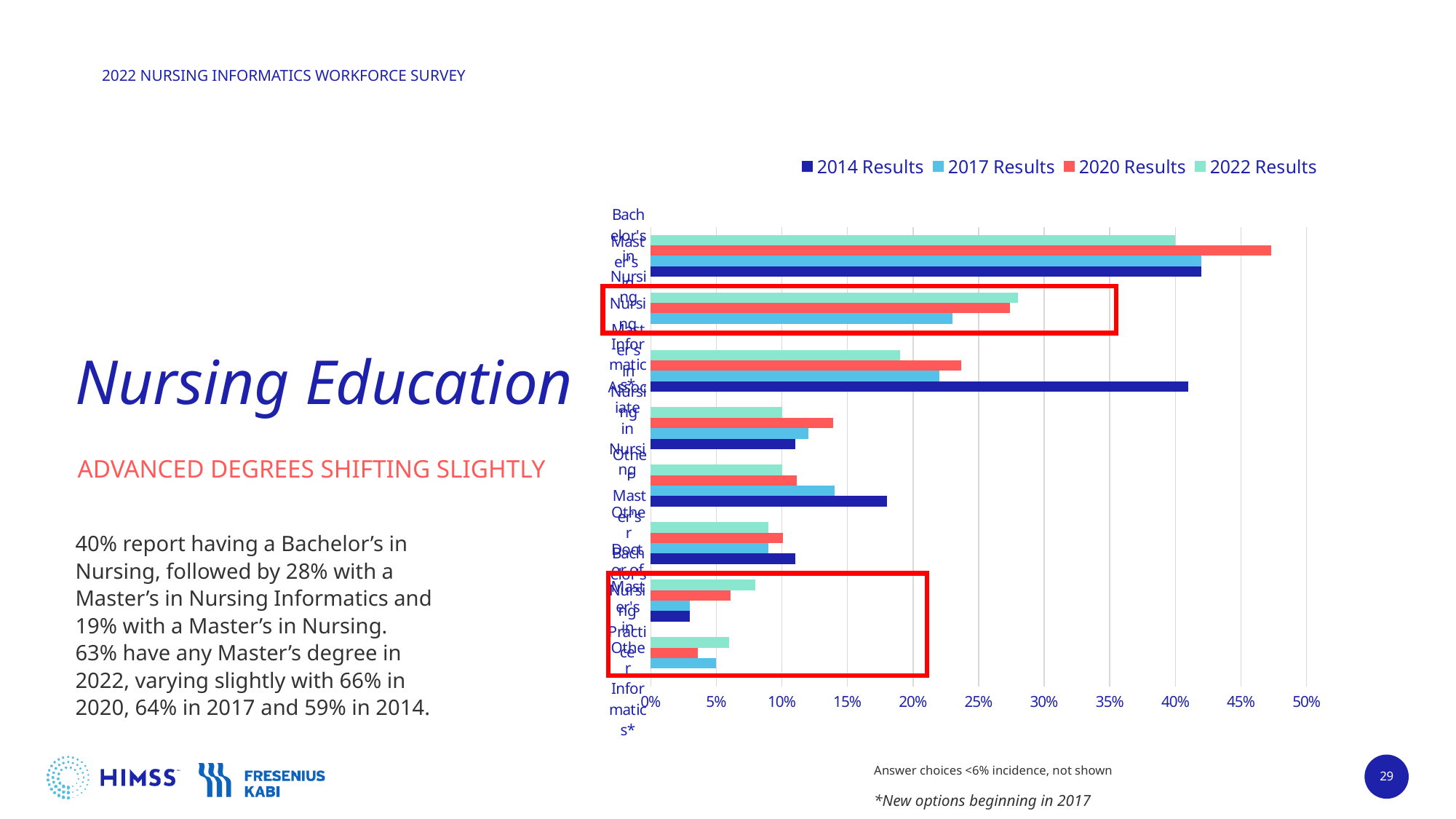
Is the 2022 Results value for the top category greater or less than 35%? greater In the third category from the top, which series has the highest value? 2014 Results How many series does the chart legend list? 4 In the top category of the chart, which series has the highest value? 2020 Results What is the highest value shown on the chart's x axis? 50% Is the 2020 Results value for the top category greater or less than 45%? greater Is the 2022 Results value for the second category from the top greater or less than 25%? greater What are the series names listed in the chart legend? 2014 Results, 2017 Results, 2020 Results, 2022 Results What is the 2022 Results value for Bachelor's in Nursing, the top category in the chart? 40% What kind of chart is shown on the slide? bar chart How many category groups of bars are plotted in the chart? 8